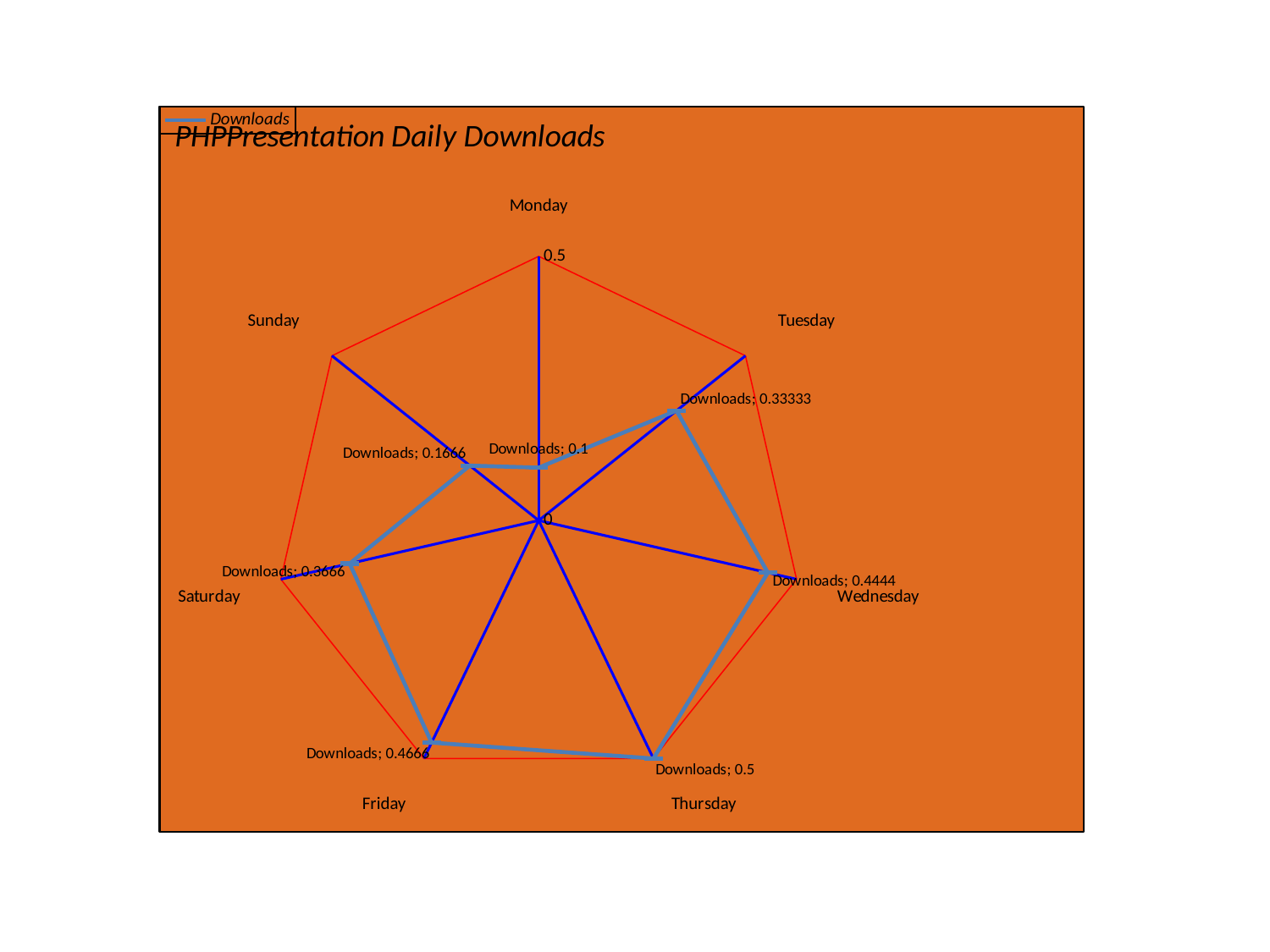
What is the Downloads value for Monday? 0.1 Which day has the lowest Downloads value? Monday Which day has the highest Downloads value? Thursday What is the Downloads value for Wednesday? 0.4444 What is the Downloads value for Tuesday? 0.33333 What is the difference between the Downloads values for Thursday and Monday? 0.4 How many categories (days) are plotted on the chart? 7 What type of chart is shown on the slide? Radar chart What is the title of the chart? PHPPresentation Daily Downloads What is the Downloads value for Sunday? 0.1666 Is the Downloads value for Friday greater or less than 0.5? less How many series does the legend list? 1